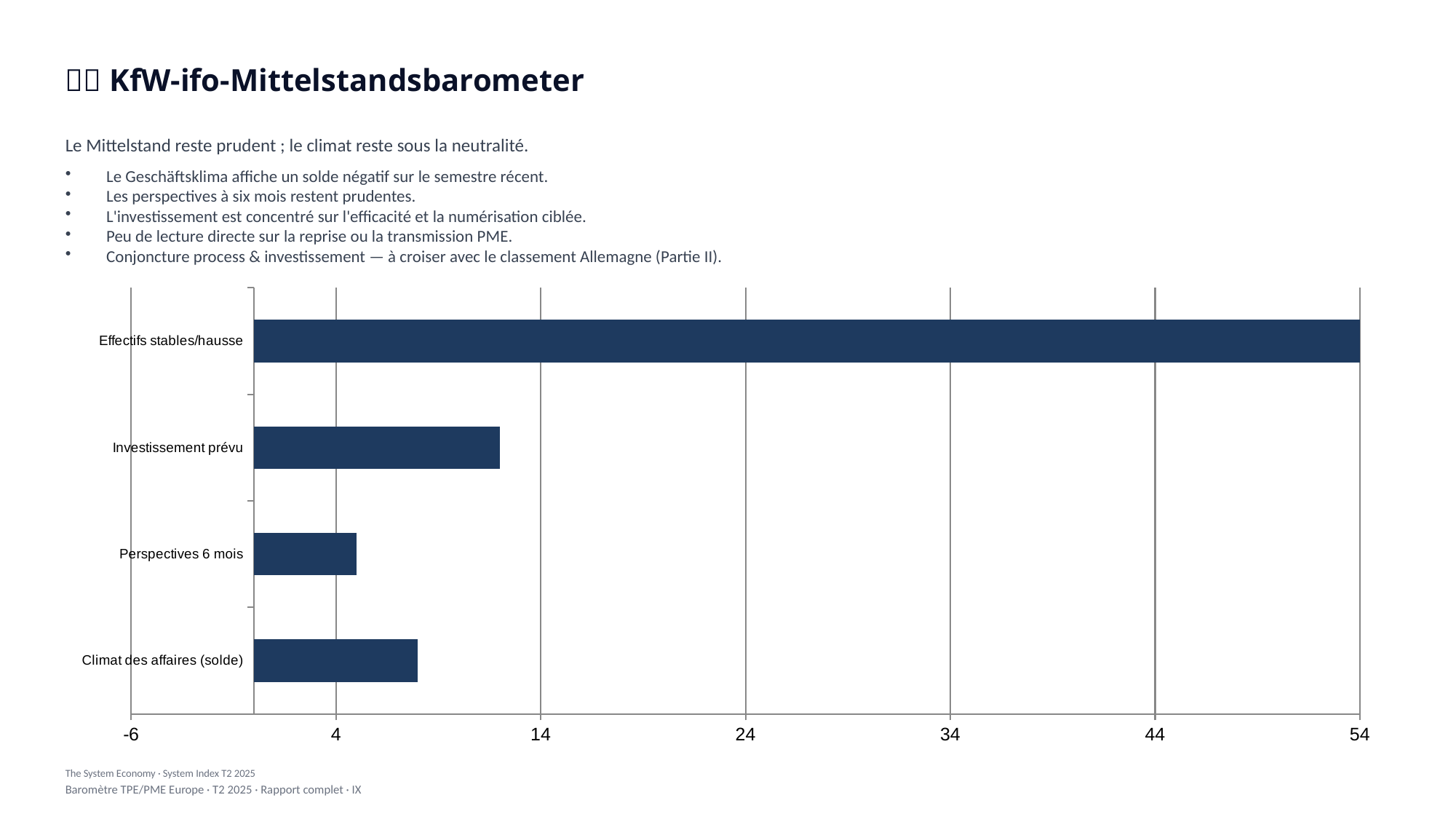
Which is larger: the value for Perspectives 6 mois or the value for Climat des affaires (solde)? Climat des affaires (solde) Is the value for Perspectives 6 mois greater or less than 14? less Which category has the lowest value in the chart? Perspectives 6 mois Which is larger: the value for Investissement prévu or the value for Climat des affaires (solde)? Investissement prévu Is the value for Investissement prévu greater or less than 14? less What is the value for Effectifs stables/hausse? 54 What is the title of the slide containing the chart? KfW-ifo-Mittelstandsbarometer Which category has the highest value in the chart? Effectifs stables/hausse Is the value for Climat des affaires (solde) greater or less than 4? greater What kind of chart is shown on the slide? bar chart How many categories are plotted in the chart? 4